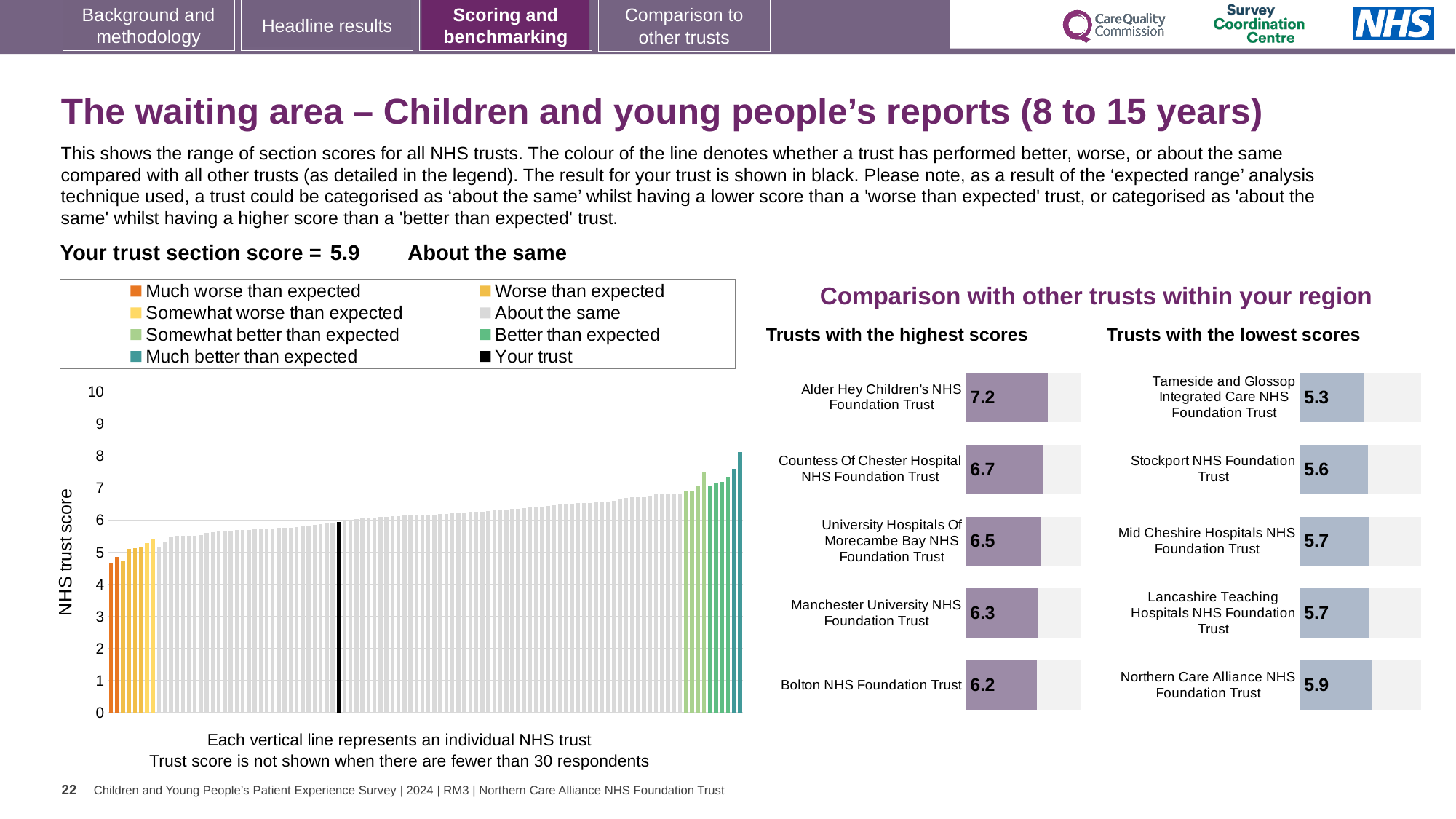
In the 'Trusts with the highest scores' chart, what is the difference between the scores of Alder Hey Children's NHS Foundation Trust and Countess Of Chester Hospital NHS Foundation Trust? 0.5 What type of chart is the large chart on the left showing all NHS trust scores? Bar chart What is the y-axis label of the large chart on the left? NHS trust score In the 'Trusts with the highest scores' chart, which trust has the highest score? Alder Hey Children's NHS Foundation Trust In the 'Trusts with the highest scores' chart, what is the score for Alder Hey Children's NHS Foundation Trust? 7.2 In the 'Trusts with the lowest scores' chart, which trust has the lowest score? Tameside and Glossop Integrated Care NHS Foundation Trust In the 'Trusts with the highest scores' chart, what is the score for Bolton NHS Foundation Trust? 6.2 In the 'Trusts with the lowest scores' chart, what is the difference between the scores of Northern Care Alliance NHS Foundation Trust and Tameside and Glossop Integrated Care NHS Foundation Trust? 0.6 How many trusts are shown in the 'Trusts with the highest scores' chart? 5 How many entries does the legend of the large chart on the left list? 8 In the 'Trusts with the lowest scores' chart, which has the higher score: Stockport NHS Foundation Trust or Mid Cheshire Hospitals NHS Foundation Trust? Mid Cheshire Hospitals NHS Foundation Trust In the 'Trusts with the lowest scores' chart, what is the score for Northern Care Alliance NHS Foundation Trust? 5.9